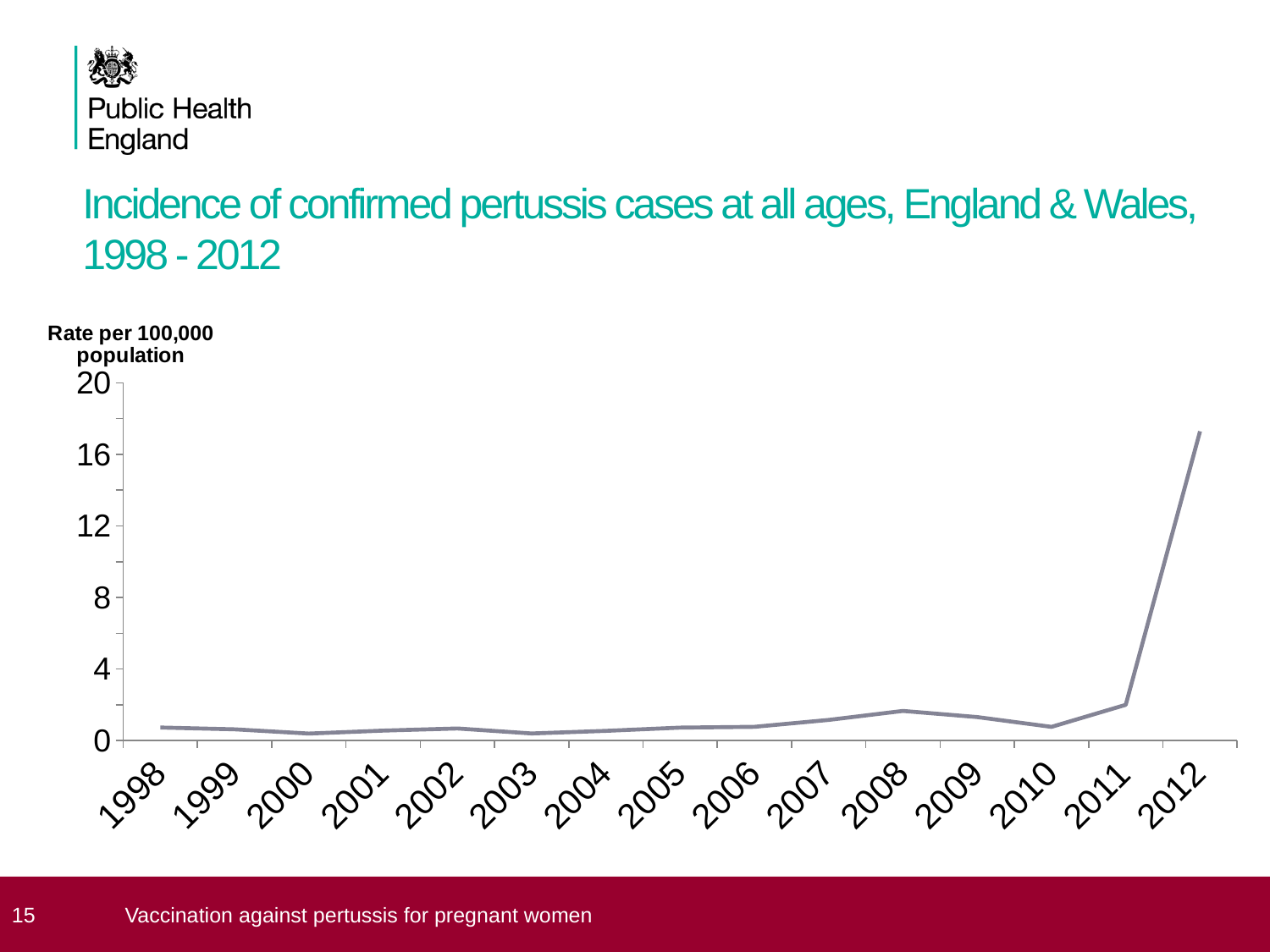
Does the line rise or fall between 2011 and 2012? rise Which year has the highest incidence rate in the chart? 2012 Is the value for 2003 greater or less than 4? less What is the label of the y axis of the chart? Rate per 100,000 population What is the highest value shown on the y axis of the chart? 20 Is the value for 2012 greater or less than 12? greater Is the value for 2011 greater or less than 4? less How many years are plotted along the x axis of the chart? 15 How many lines (series) are plotted in the chart? 1 Which year has the larger value, 2011 or 2012? 2012 What kind of chart is shown on the slide? line chart